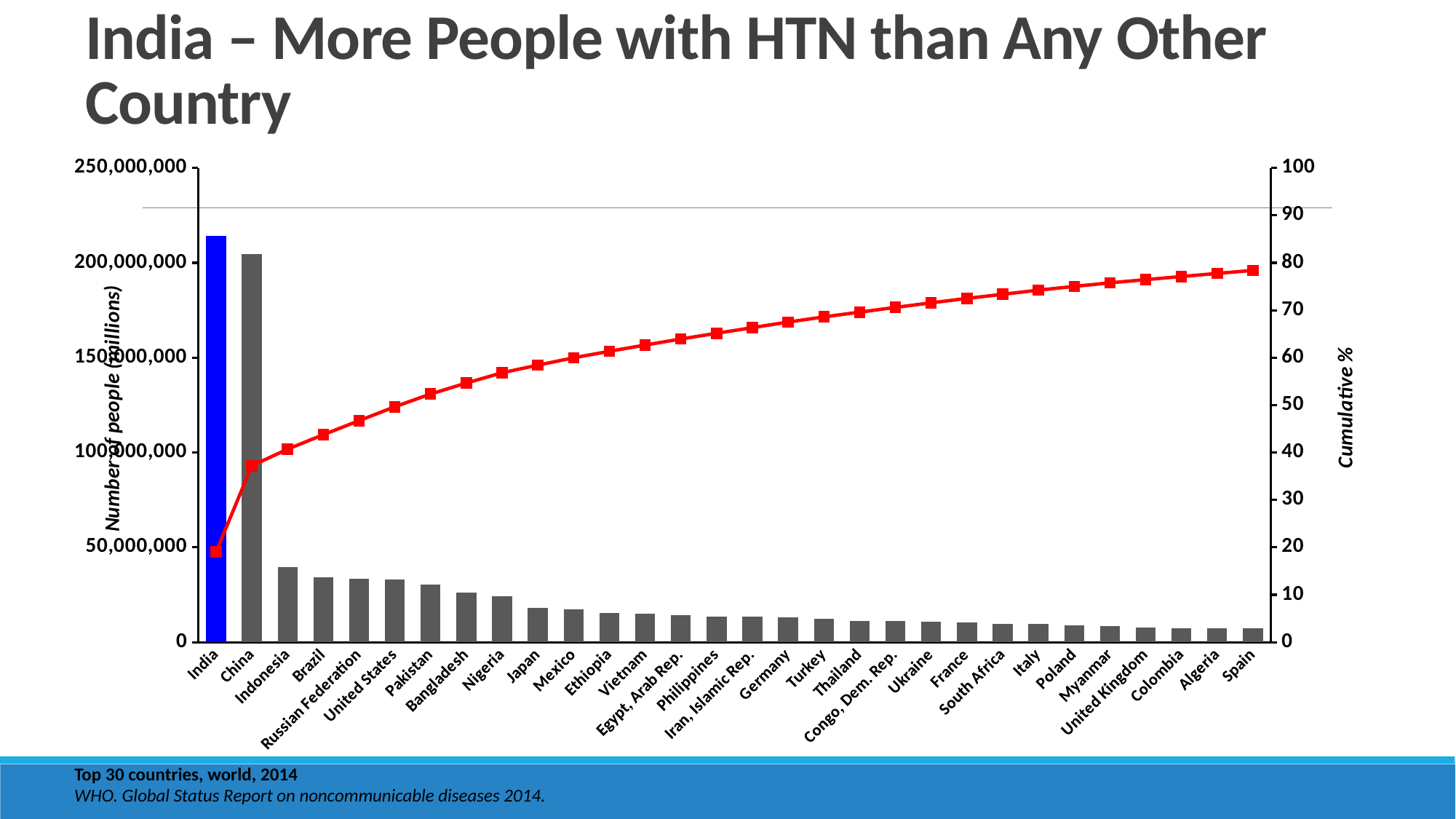
Is the value for India greater or less than 200,000,000? greater Is the cumulative % value for Spain greater or less than 80? less Which country has the highest number of people with HTN? India What colour is the bar for India? blue Is the cumulative % value for China greater or less than 30? greater Does the red cumulative % line rise or fall from left to right? rise Which has more people with HTN, India or China? India Which has more people with HTN, Indonesia or Brazil? Indonesia Do the bar values rise or fall from left to right along the x axis? fall How many countries are shown on the x axis? 30